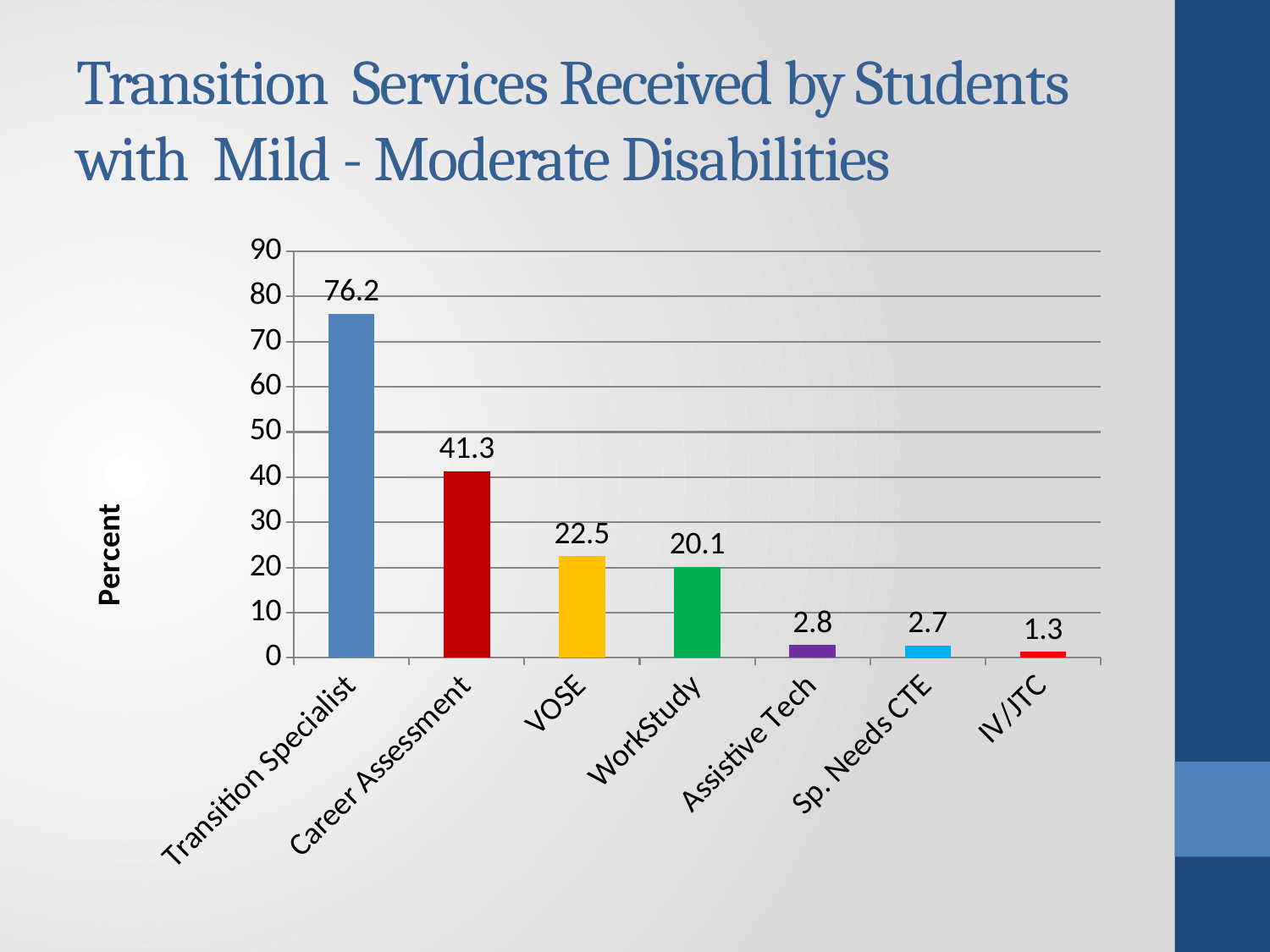
What is the difference between the values for Transition Specialist and Career Assessment? 34.9 What is the value for WorkStudy? 20.1 What is the label of the vertical axis? Percent What is the value for Sp. Needs CTE? 2.7 Which category has the lowest value? IV/JTC How many categories are shown on the x axis? 7 What is the value for Transition Specialist? 76.2 What is the value for Career Assessment? 41.3 Is the value for Career Assessment greater or less than 40? greater What kind of chart is shown on the slide? bar chart Which is larger, the value for VOSE or the value for WorkStudy? VOSE Which category has the highest value? Transition Specialist